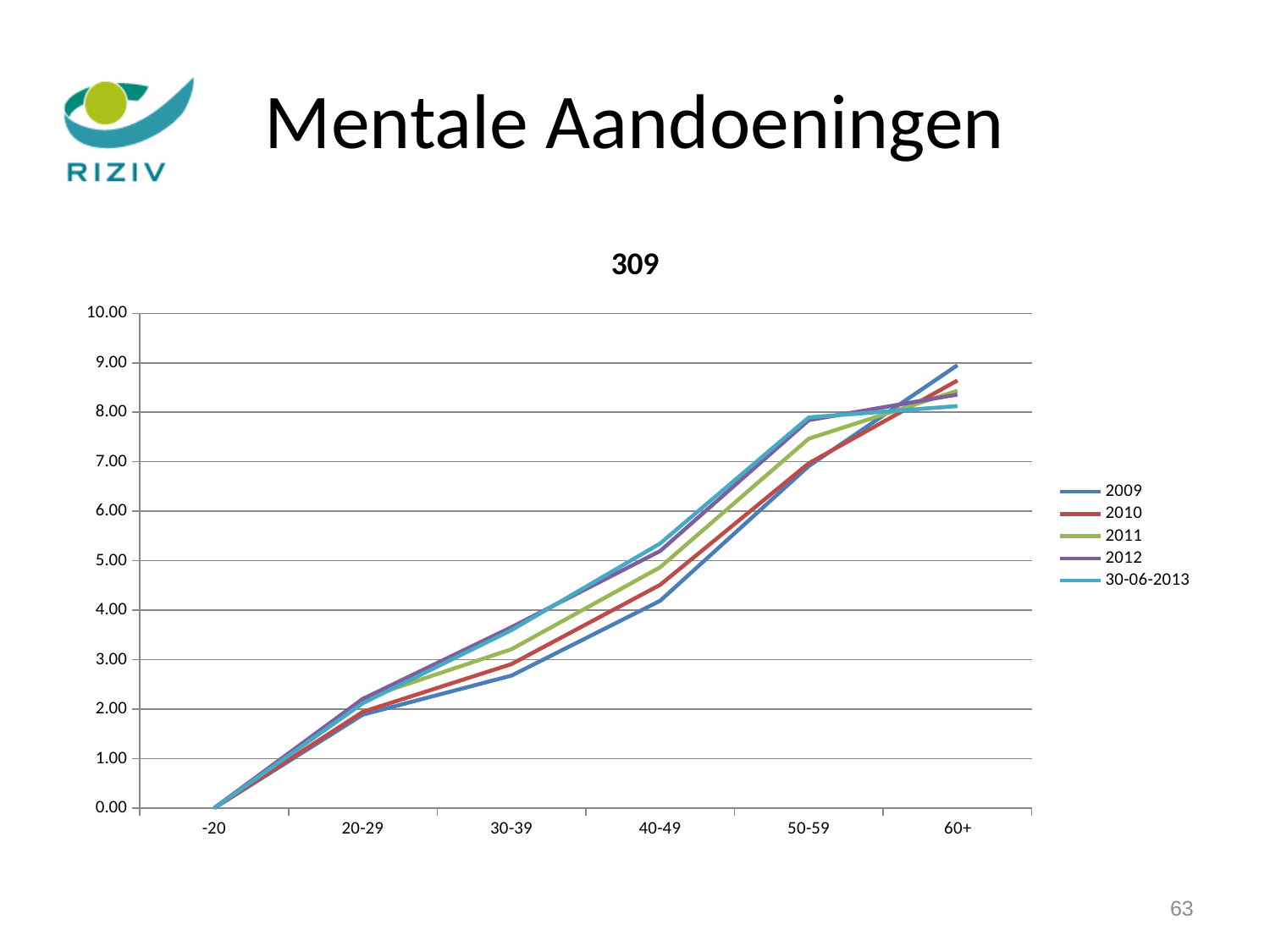
What kind of chart is shown on the slide? line chart At 40-49, which is larger: the value for 2009 or the value for 30-06-2013? 30-06-2013 What is the title of the chart? 309 Is the value for 2009 at 40-49 greater or less than 5.00? less Which series has the highest value at 60+? 2009 Which series has the lowest value at 60+? 30-06-2013 Which series has the lowest value at 40-49? 2009 How many age categories are shown on the x axis? 6 Is the value for 30-06-2013 at 50-59 greater or less than 7.00? greater How many series does the legend list? 5 Do the values for the 2009 series rise or fall from -20 to 60+? rise Is the value for 2009 at 60+ greater or less than 8.00? greater